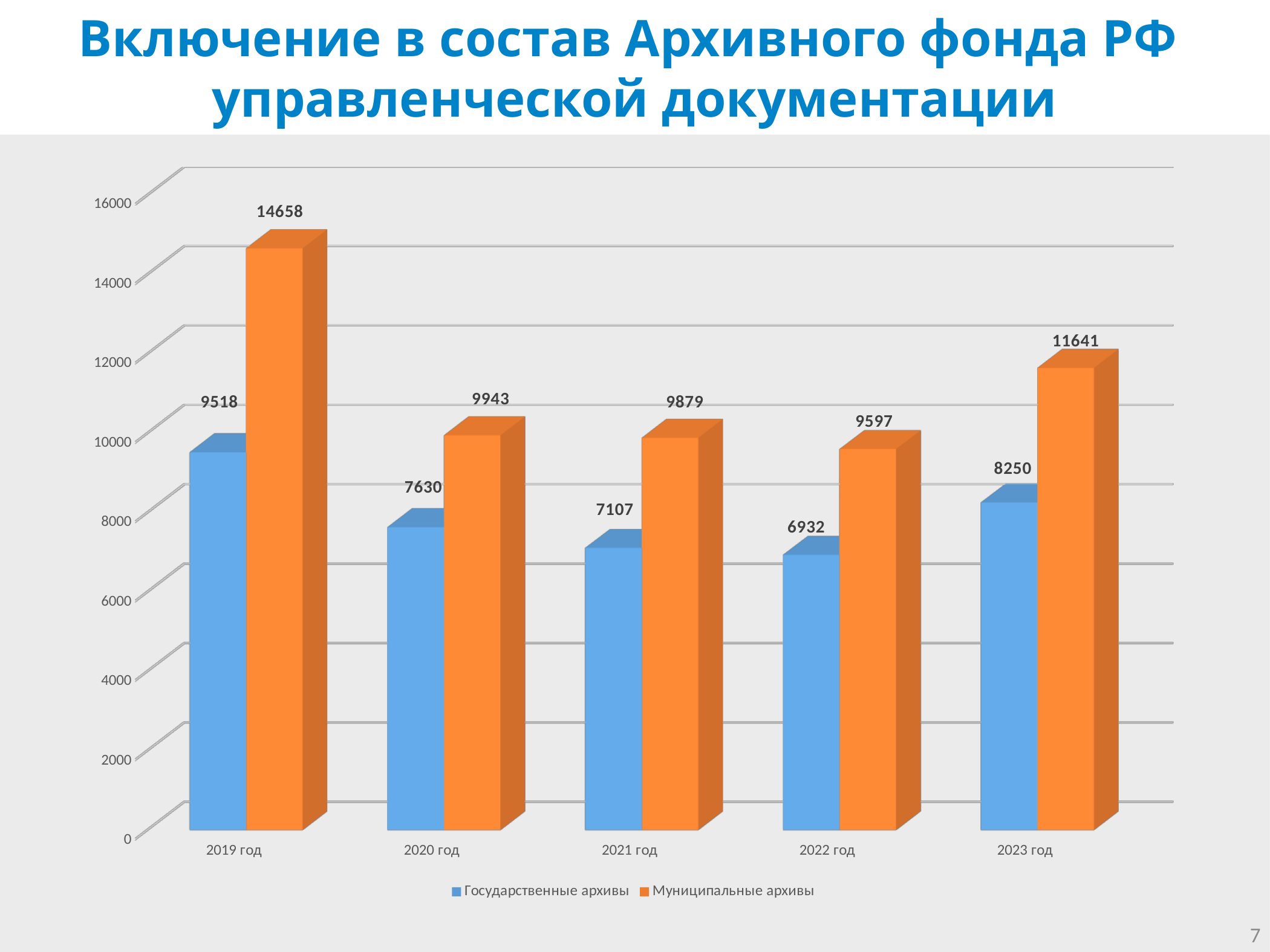
Which year has the lowest value for Государственные архивы? 2022 год Is the value for Государственные архивы in 2023 год greater or less than 8000? greater How many series does the legend list? 2 What is the value for Муниципальные архивы in 2023 год? 11641 What is the difference between Муниципальные архивы and Государственные архивы in 2020 год? 2313 What is the value for Государственные архивы in 2019 год? 9518 How many years are shown on the x axis? 5 What kind of chart is shown on the slide? bar chart What is the value for Муниципальные архивы in 2021 год? 9879 Which is larger in 2022 год: Государственные архивы or Муниципальные архивы? Муниципальные архивы Which colour represents Муниципальные архивы in the chart? orange Which year has the highest value for Муниципальные архивы? 2019 год